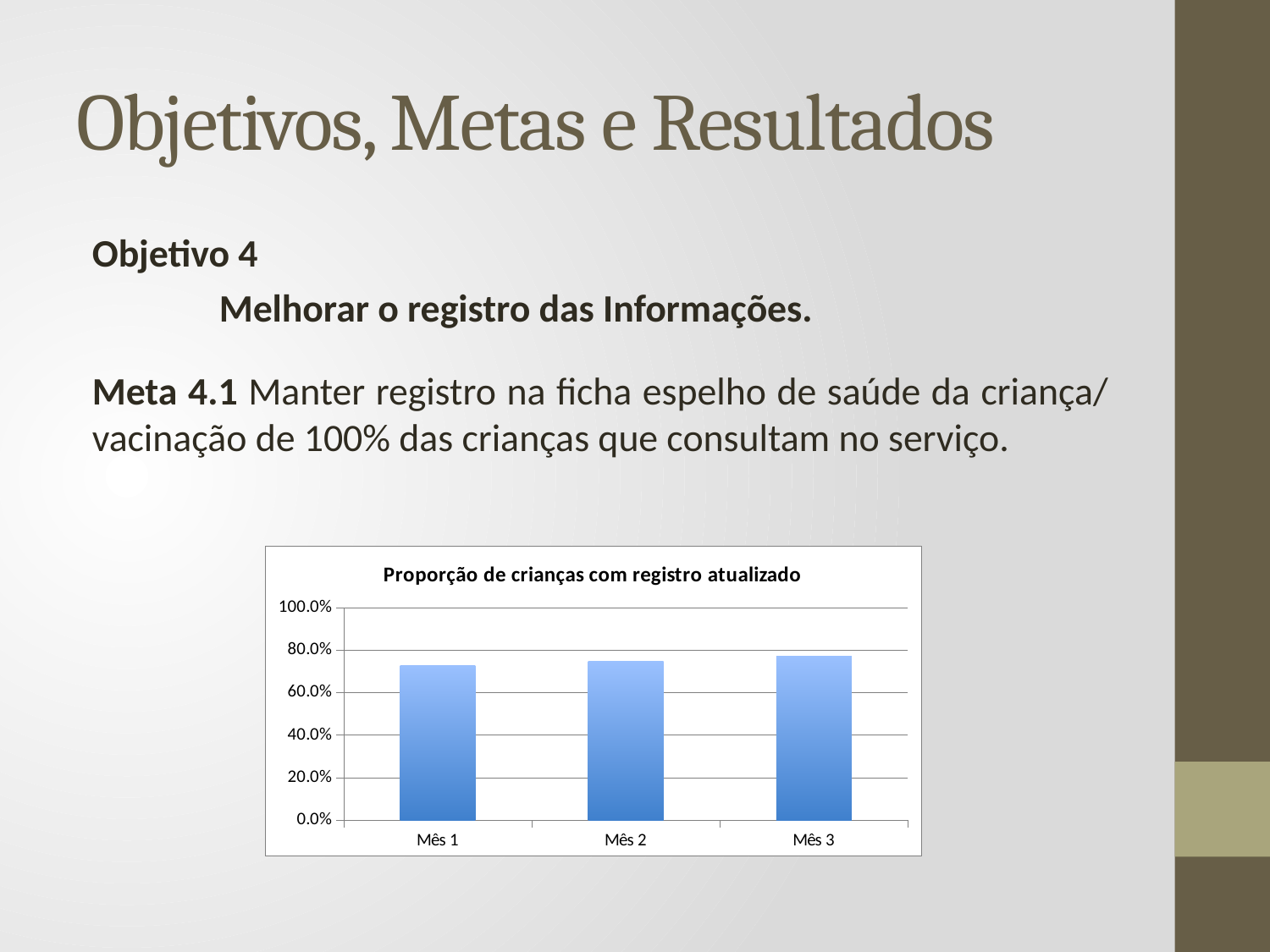
Is the value for Mês 3 greater or less than 60.0%? greater What is the title of the chart? Proporção de crianças com registro atualizado How many categories (months) are shown on the x axis of the chart? 3 Is the value for Mês 1 greater or less than 80.0%? less Is the value for Mês 2 greater or less than 80.0%? less What kind of chart is shown on the slide? bar chart What is the highest tick value shown on the y axis of the chart? 100.0% Do the values rise or fall from Mês 1 to Mês 3? rise Which is larger, the value for Mês 1 or the value for Mês 3? Mês 3 Which month has the lowest value in the chart? Mês 1